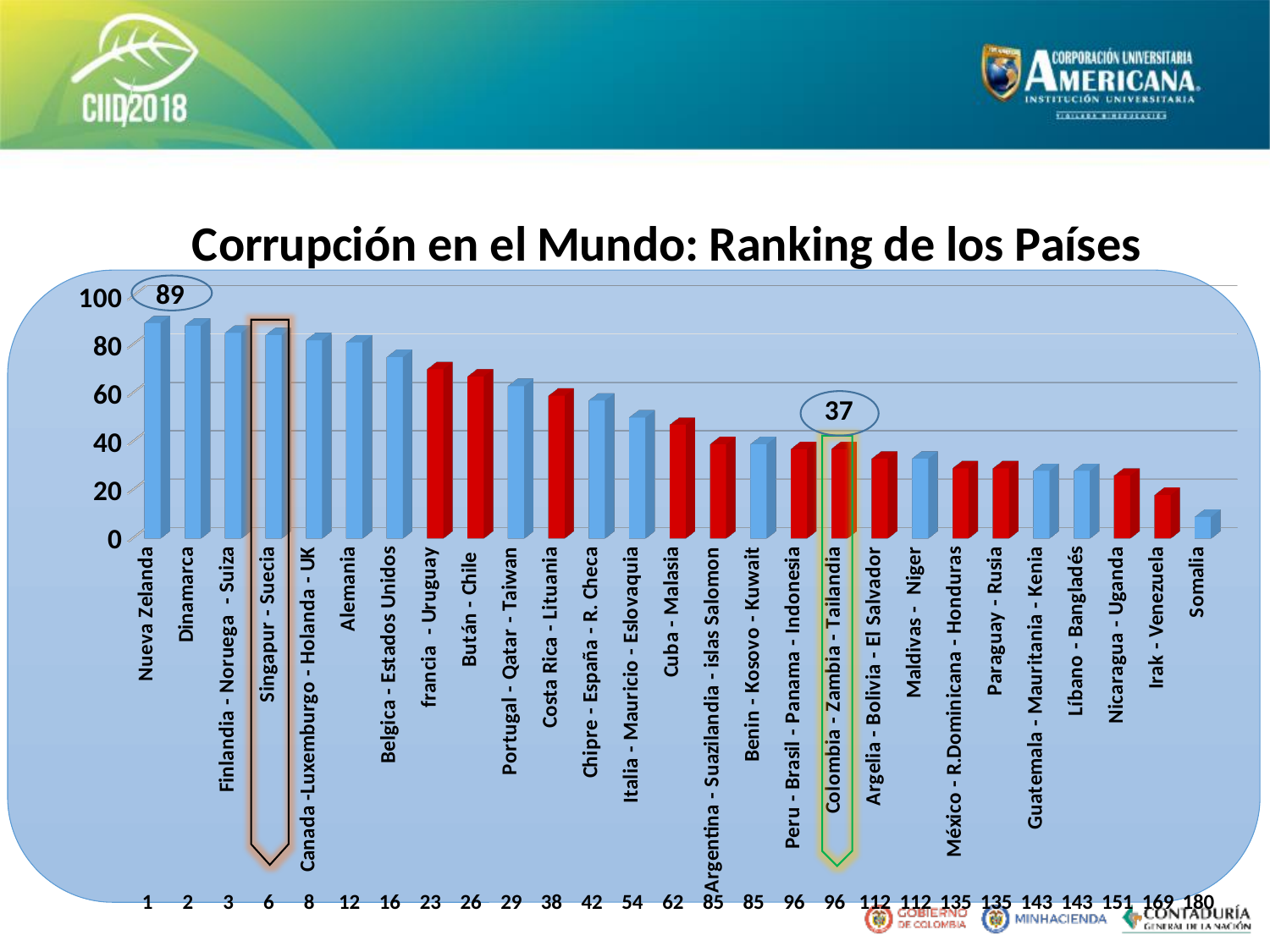
What is the title of the chart? Corrupción en el Mundo: Ranking de los Países Which has the larger bar, Irak - Venezuela or Somalia? Irak - Venezuela Is the value for Belgica - Estados Unidos greater or less than 60? greater How many categories are plotted along the x axis of the chart? 27 Do the bar values rise or fall from left to right along the x axis? Fall Is the value for Cuba - Malasia greater or less than 40? greater What value is labelled on the bar for Colombia - Zambia - Tailandia? 37 What is the difference between the labelled values for Nueva Zelanda and Colombia - Zambia - Tailandia? 52 What kind of chart is shown on the slide? Bar chart Which category has the lowest bar in the chart? Somalia Is the value for Somalia greater or less than 20? less What value is labelled on the bar for Nueva Zelanda? 89